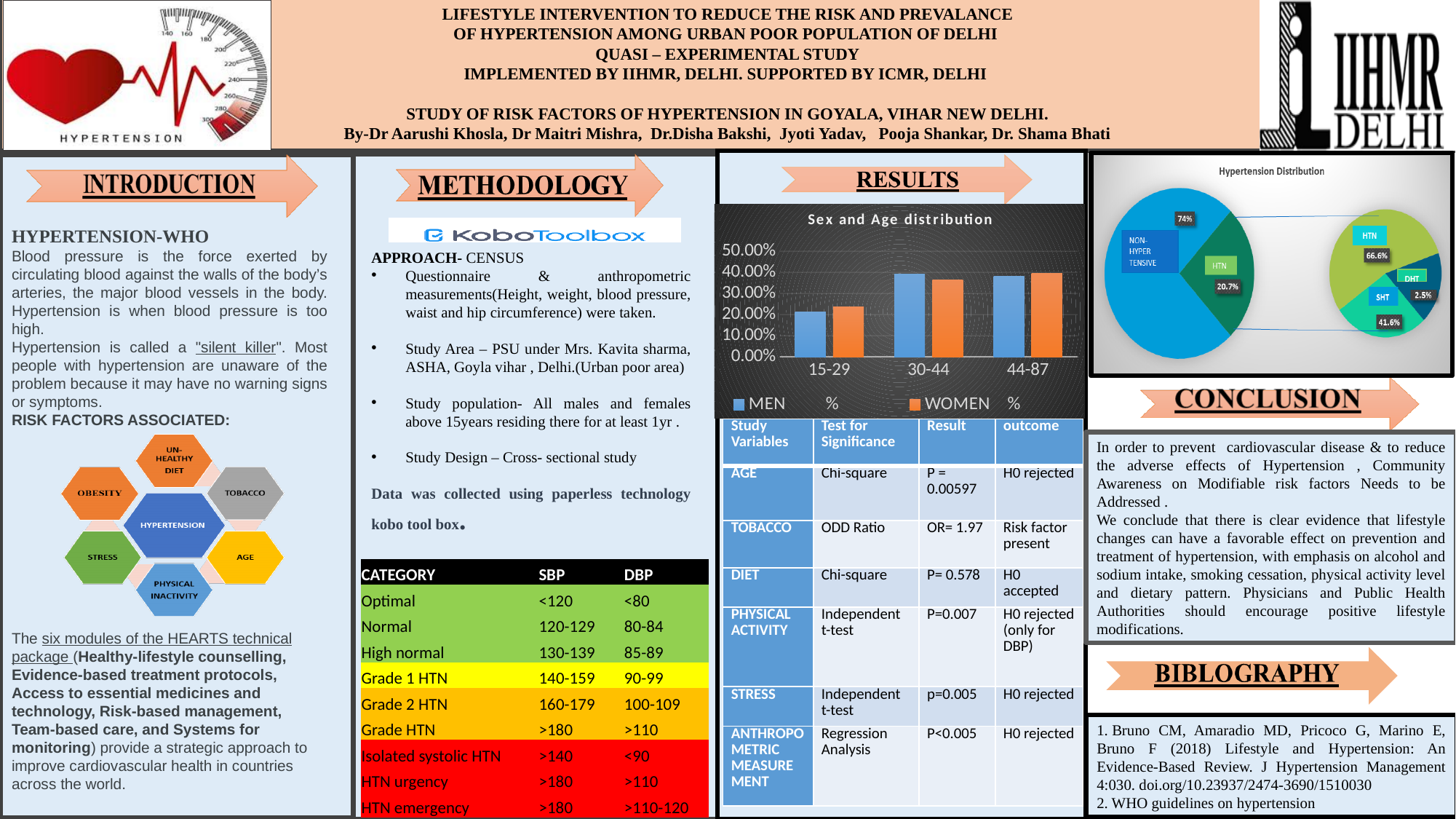
In the 'Sex and Age distribution' chart, which is larger for the 15-29 group, MEN or WOMEN? WOMEN In the 'Sex and Age distribution' chart, which age group has the lowest MEN value? 15-29 What kind of chart is the 'Sex and Age distribution' chart? bar chart In the 'Sex and Age distribution' chart, is the WOMEN value for the 30-44 group greater or less than 30.00%? greater In the 'Sex and Age distribution' chart, is the MEN value for the 15-29 group greater or less than 30.00%? less In the 'Sex and Age distribution' chart, which is larger for the 30-44 group, MEN or WOMEN? MEN How many series does the legend of the 'Sex and Age distribution' chart list? 2 In the 'Hypertension Distribution' pie chart, what share is labelled NON-HYPERTENSIVE? 74% In the 'Hypertension Distribution' chart, what percentage is shown for the SHT slice? 41.6% In the 'Sex and Age distribution' chart, is the MEN value for the 44-87 group greater or less than 30.00%? greater In the 'Hypertension Distribution' chart, what percentage is shown for the DHT slice? 2.5% How many age groups are shown on the x axis of the 'Sex and Age distribution' chart? 3